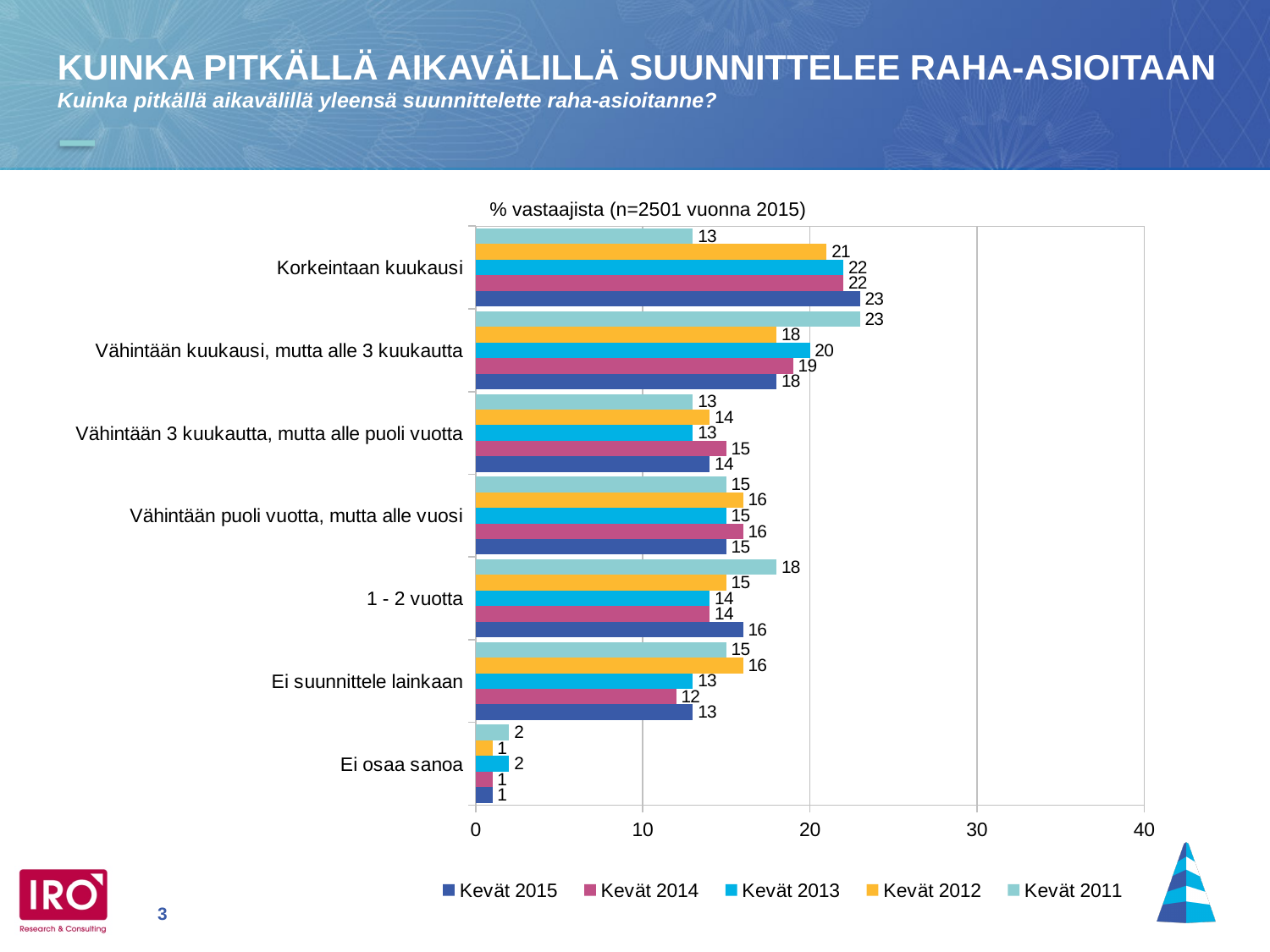
What type of chart is shown on the slide? bar chart What is the title printed above the chart? % vastaajista (n=2501 vuonna 2015) For the category "1 - 2 vuotta", which is larger: the Kevät 2011 value or the Kevät 2013 value? Kevät 2011 What is the difference between the Kevät 2015 and Kevät 2011 values for "Korkeintaan kuukausi"? 10 How many categories are shown on the chart? 7 Which category has the highest value for Kevät 2013? Korkeintaan kuukausi What is the value for Kevät 2014 in the category "Ei suunnittele lainkaan"? 12 What is the value for Kevät 2011 in the category "Vähintään kuukausi, mutta alle 3 kuukautta"? 23 How many series does the legend list? 5 Which category has the lowest value for Kevät 2015? Ei osaa sanoa Is the Kevät 2012 value for "Korkeintaan kuukausi" greater or less than 20? greater What is the value for Kevät 2015 in the category "Korkeintaan kuukausi"? 23